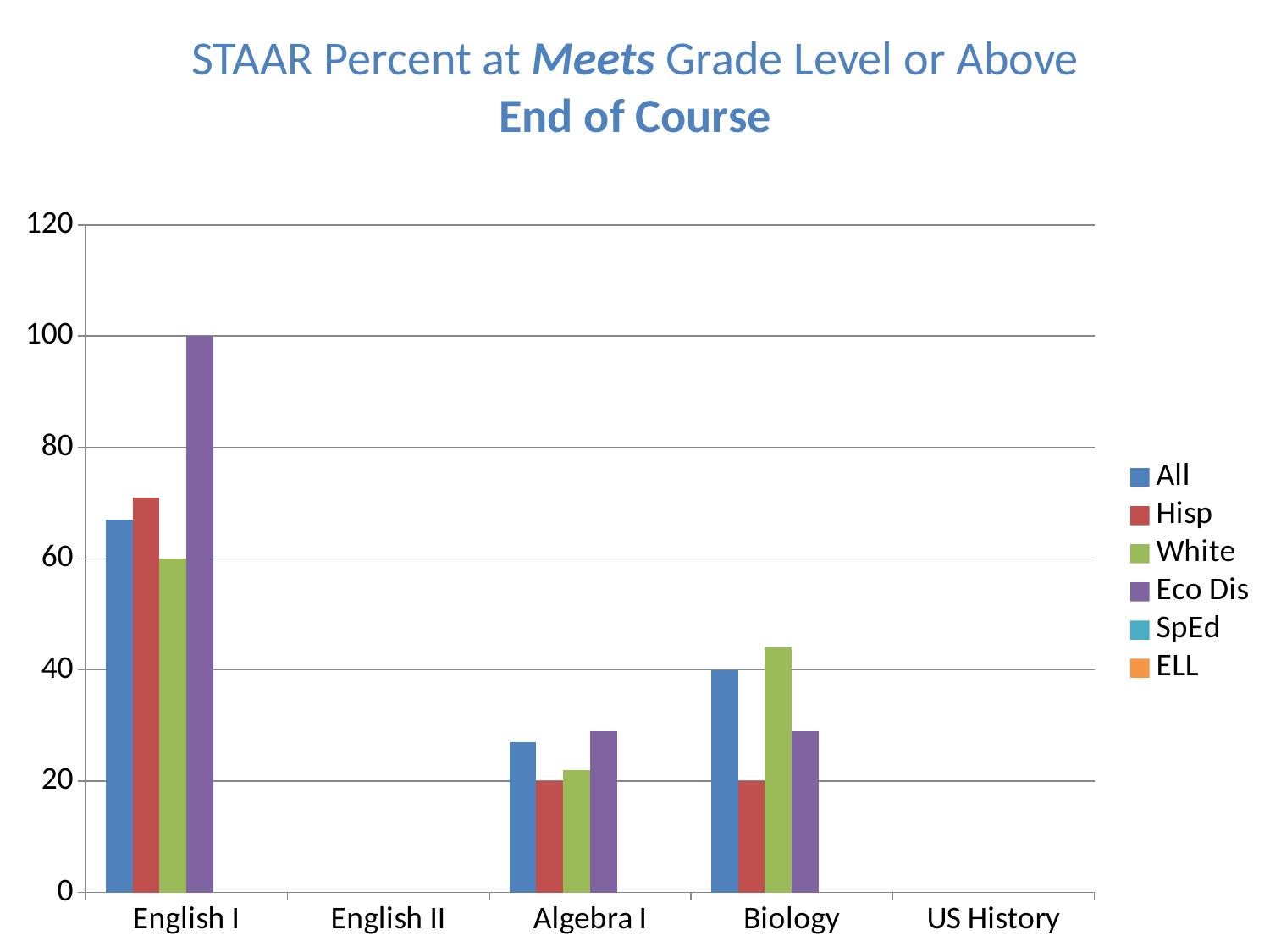
Which series has the highest bar in English I? Eco Dis What is the value for Hisp in Biology? 20 Which series has the lowest bar in Biology? Hisp What is the value for White in English I? 60 What kind of chart is shown on the slide? bar chart Which is larger in Algebra I, the Eco Dis bar or the Hisp bar? Eco Dis What is the difference between the All and Hisp values in Biology? 20 How many course categories are shown on the x axis? 5 How many series does the legend list? 6 Is the value for All in English I greater or less than 60? greater What is the value for All in Biology? 40 What is the value for Eco Dis in English I? 100